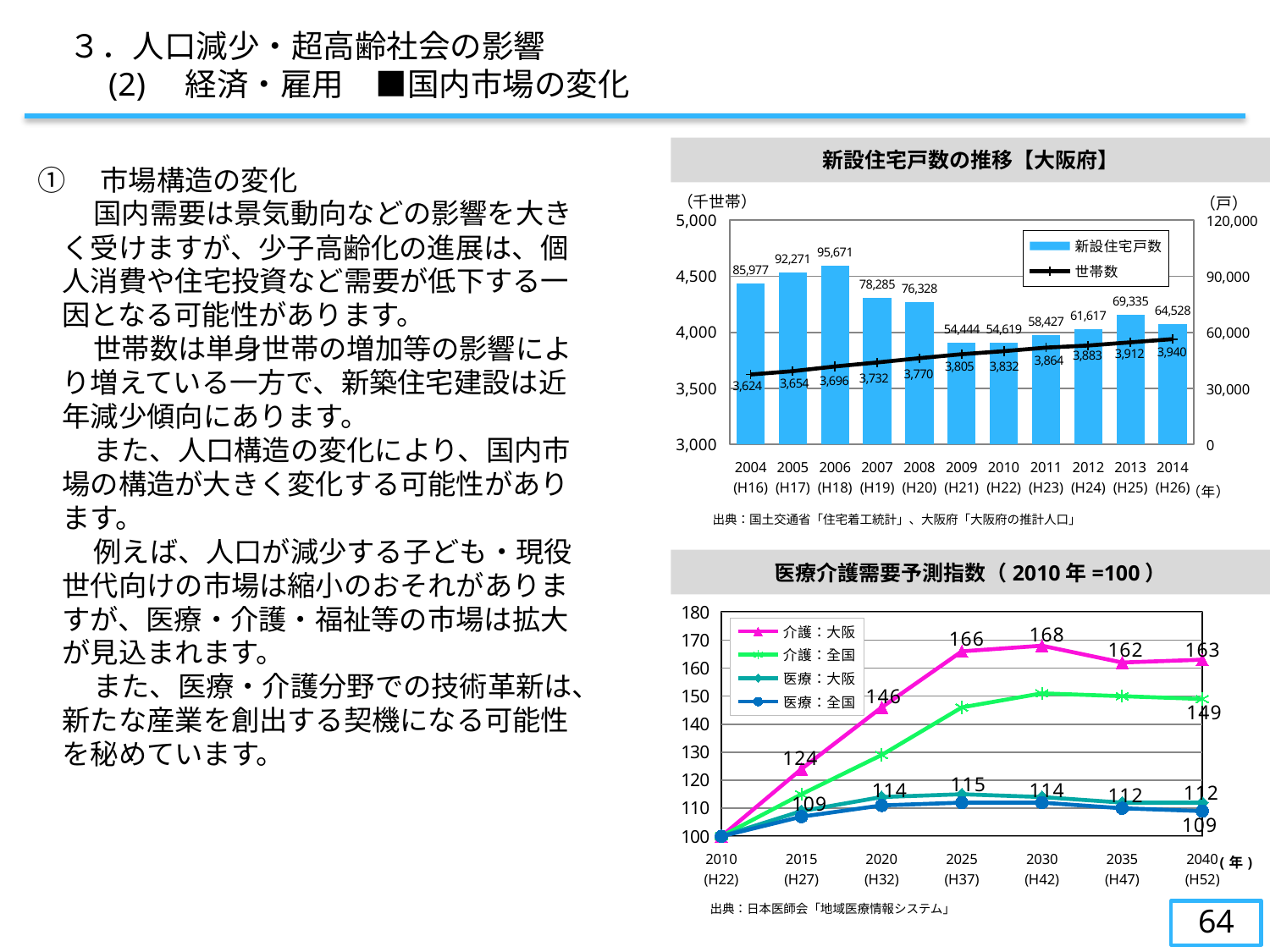
In the 新設住宅戸数の推移【大阪府】 chart, does the 世帯数 line rise or fall from 2004 to 2014? rise In the 医療介護需要予測指数 chart, what is the value of 医療：大阪 in 2025 (H37)? 115 In the 医療介護需要予測指数 chart, which is larger in 2040 (H52): 介護：大阪 or 介護：全国? 介護：大阪 In the 新設住宅戸数の推移【大阪府】 chart, what is the difference in 新設住宅戸数 between 2013 (H25) and 2014 (H26)? 4,807 In the 医療介護需要予測指数 chart, how many series does the legend list? 4 In the 新設住宅戸数の推移【大阪府】 chart, how many series does the legend list? 2 In the 新設住宅戸数の推移【大阪府】 chart, what is the 世帯数 value for 2014 (H26)? 3,940 In the 新設住宅戸数の推移【大阪府】 chart, which year has the lowest 新設住宅戸数? 2009 (H21) In the 新設住宅戸数の推移【大阪府】 chart, what is the value of 新設住宅戸数 for 2006 (H18)? 95,671 In the 新設住宅戸数の推移【大阪府】 chart, which year has the highest 新設住宅戸数? 2006 (H18) In the 医療介護需要予測指数 chart, what is the value of 介護：大阪 in 2030 (H42)? 168 What kind of chart is the 医療介護需要予測指数 chart? line chart